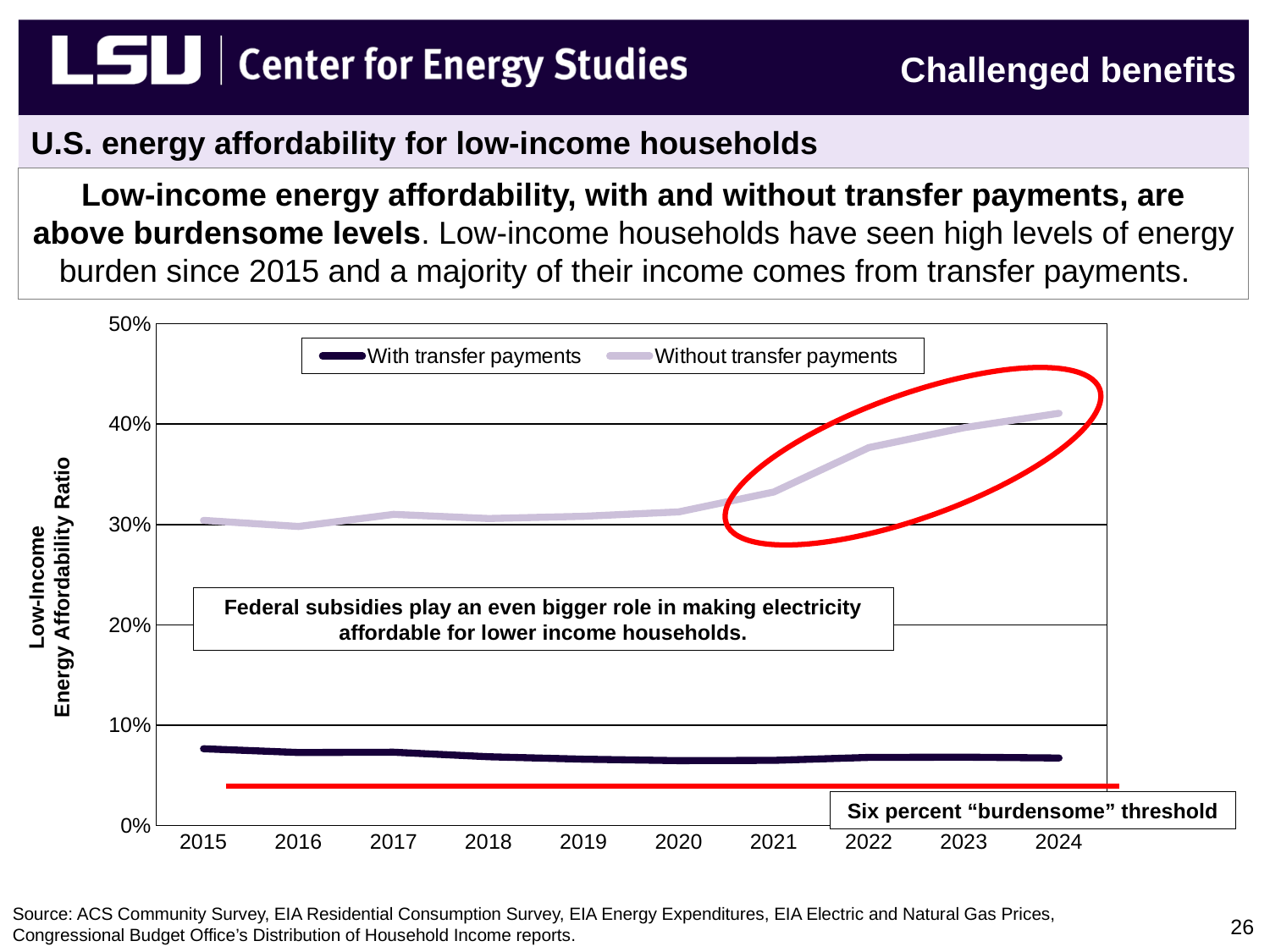
Is the 2024 value for 'Without transfer payments' greater or less than 40%? greater How many years are shown along the x axis of the chart? 10 How many series does the chart legend list? 2 Which year has the highest value for the 'Without transfer payments' series? 2024 In 2020, which series has the larger value: 'With transfer payments' or 'Without transfer payments'? Without transfer payments Does the 'Without transfer payments' series rise or fall from 2015 to 2024? Rise What is the label on the y axis of the chart? Low-Income Energy Affordability Ratio Is the 2015 value for 'With transfer payments' greater or less than 10%? less What kind of chart is shown on the slide? Line chart Is the 2021 value for 'Without transfer payments' greater or less than 30%? greater Which year has the highest value for the 'With transfer payments' series? 2015